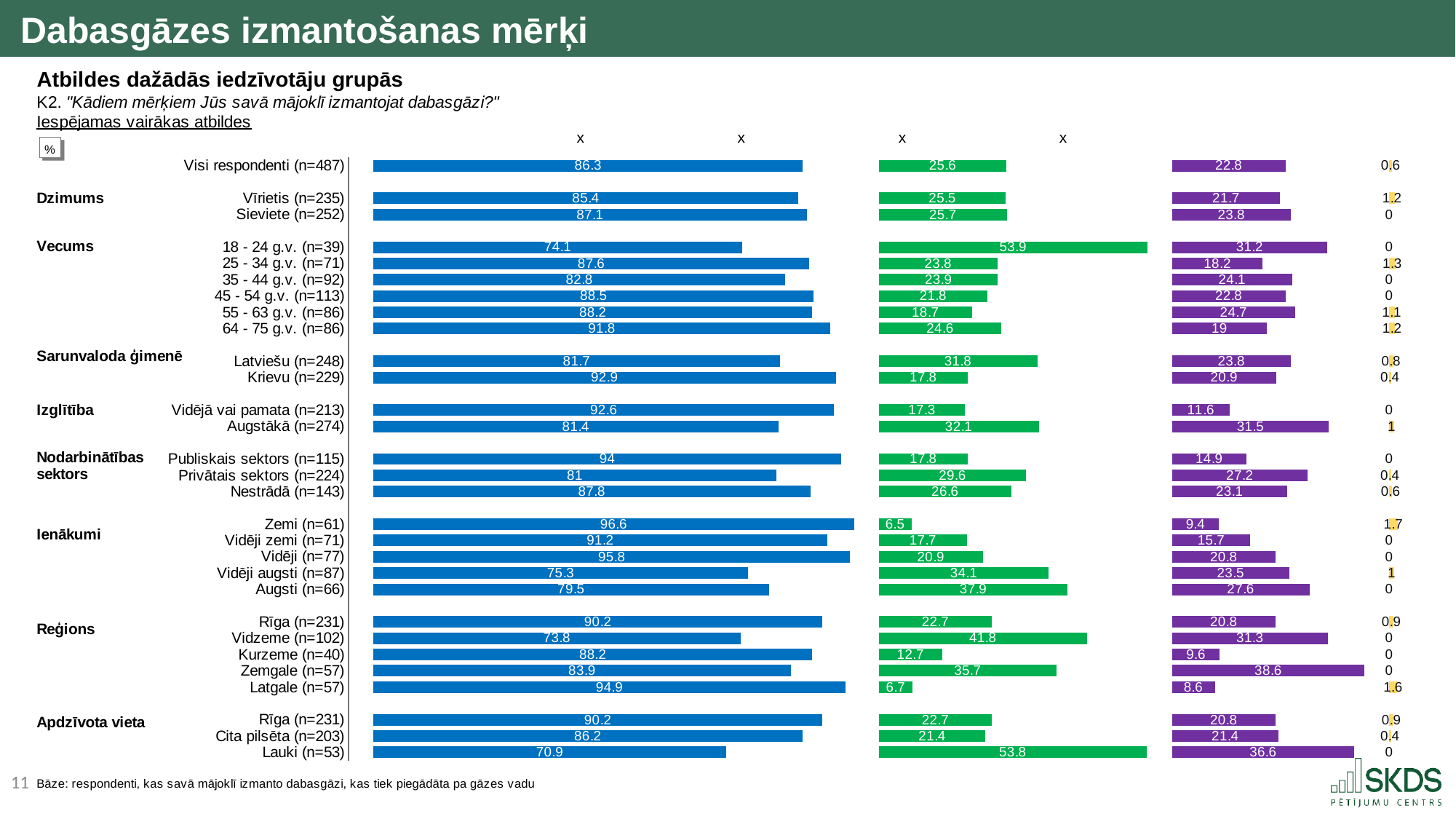
In the third (purple) bar chart, which category has the highest value? Zemgale (n=57) In the first (blue) bar chart, which category has the lowest value? Lauki (n=53) In the first (blue) bar chart, what is the value for Publiskais sektors (n=115)? 94 In the third (purple) bar chart, which is larger: the value for Augstākā (n=274) or the value for Vidējā vai pamata (n=213)? Augstākā (n=274) In the second (green) bar chart, which is larger: the value for Vidzeme (n=102) or the value for Kurzeme (n=40)? Vidzeme (n=102) What kind of chart is used on this slide? bar chart In the second (green) bar chart, what is the difference between the values for Lauki (n=53) and Rīga (n=231)? 31.1 In the second (green) bar chart, what is the value for Lauki (n=53)? 53.8 In the first (blue) bar chart, which category has the highest value? Zemi (n=61) In the first (blue) bar chart, what is the value for Visi respondenti (n=487)? 86.3 In the third (purple) bar chart, what is the value for Zemgale (n=57)? 38.6 In the first (blue) bar chart, what is the difference between the values for Sieviete (n=252) and Vīrietis (n=235)? 1.7